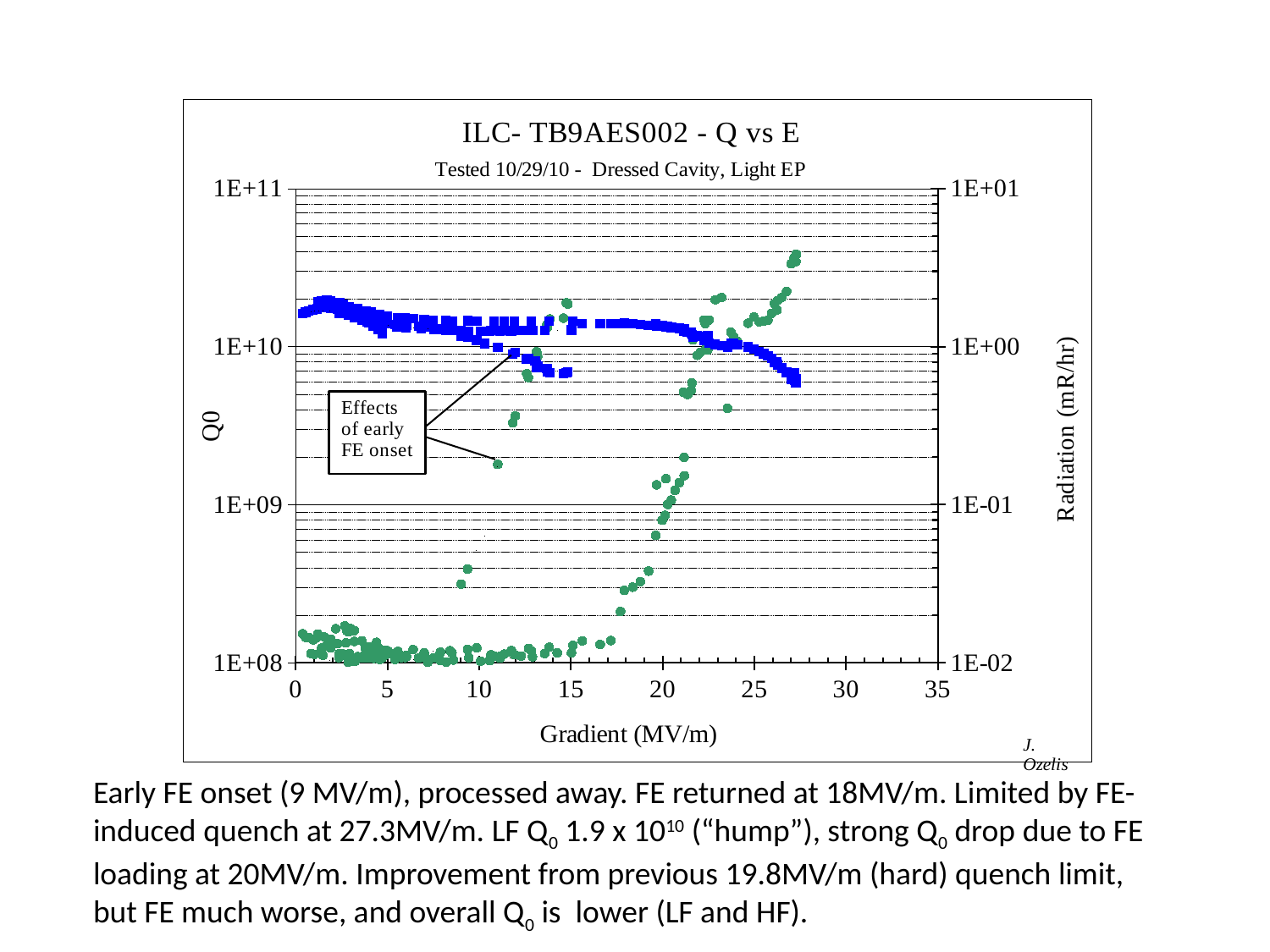
What kind of chart is shown on the slide? Scatter chart What is the title of the chart? ILC- TB9AES002 - Q vs E Is the Q0 value (blue squares) at a gradient of 27 MV/m greater or less than 1E+10? less Does the Q0 series (blue squares) rise or fall as the gradient increases from 20 MV/m to 27 MV/m? fall What text appears in the boxed annotation inside the chart? Effects of early FE onset What is the lowest tick value shown on the left y axis (Q0)? 1E+08 What is the highest tick value shown on the x axis (Gradient)? 35 Is the radiation value (green circles) at a gradient of 25 MV/m greater or less than 1E+00 mR/hr? greater How many distinct data series (marker types) are plotted on the chart? 2 Is the Q0 value (blue squares) at a gradient of 5 MV/m greater or less than 1E+10? greater Does the radiation series (green circles) rise or fall as the gradient increases from 18 MV/m to 27 MV/m? rise